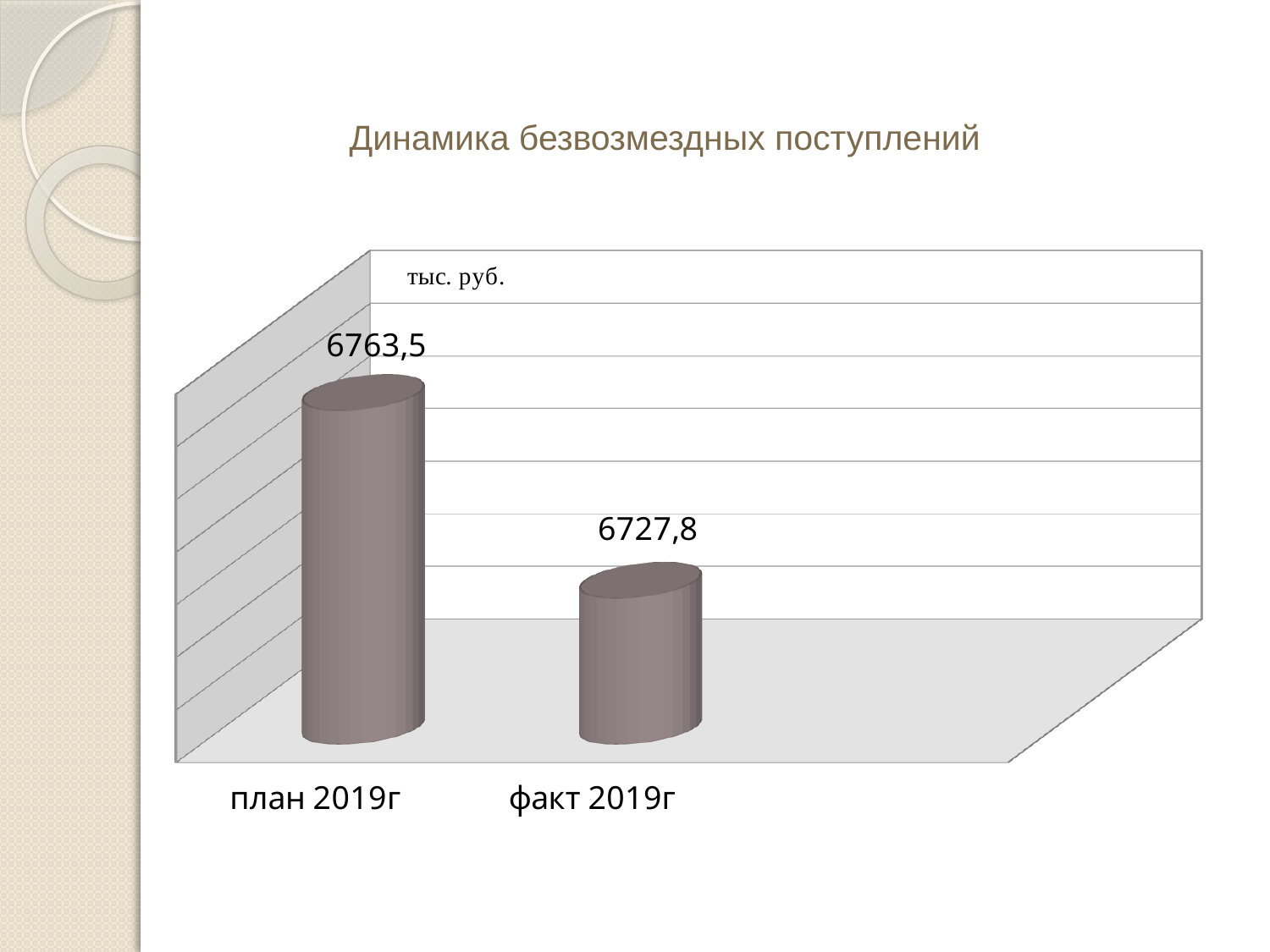
What is the value for план 2019г? 6763,5 Which is larger, the value for план 2019г or the value for факт 2019г? план 2019г How many categories are shown on the chart? 2 Which category has the highest value? план 2019г What kind of chart is shown on the slide? bar chart What is the value for факт 2019г? 6727,8 What is the difference between the values for план 2019г and факт 2019г? 35,7 Which category has the lowest value? факт 2019г What is the title of the chart? Динамика безвозмездных поступлений Do the values rise or fall from план 2019г to факт 2019г? fall What unit is indicated on the chart? тыс. руб.